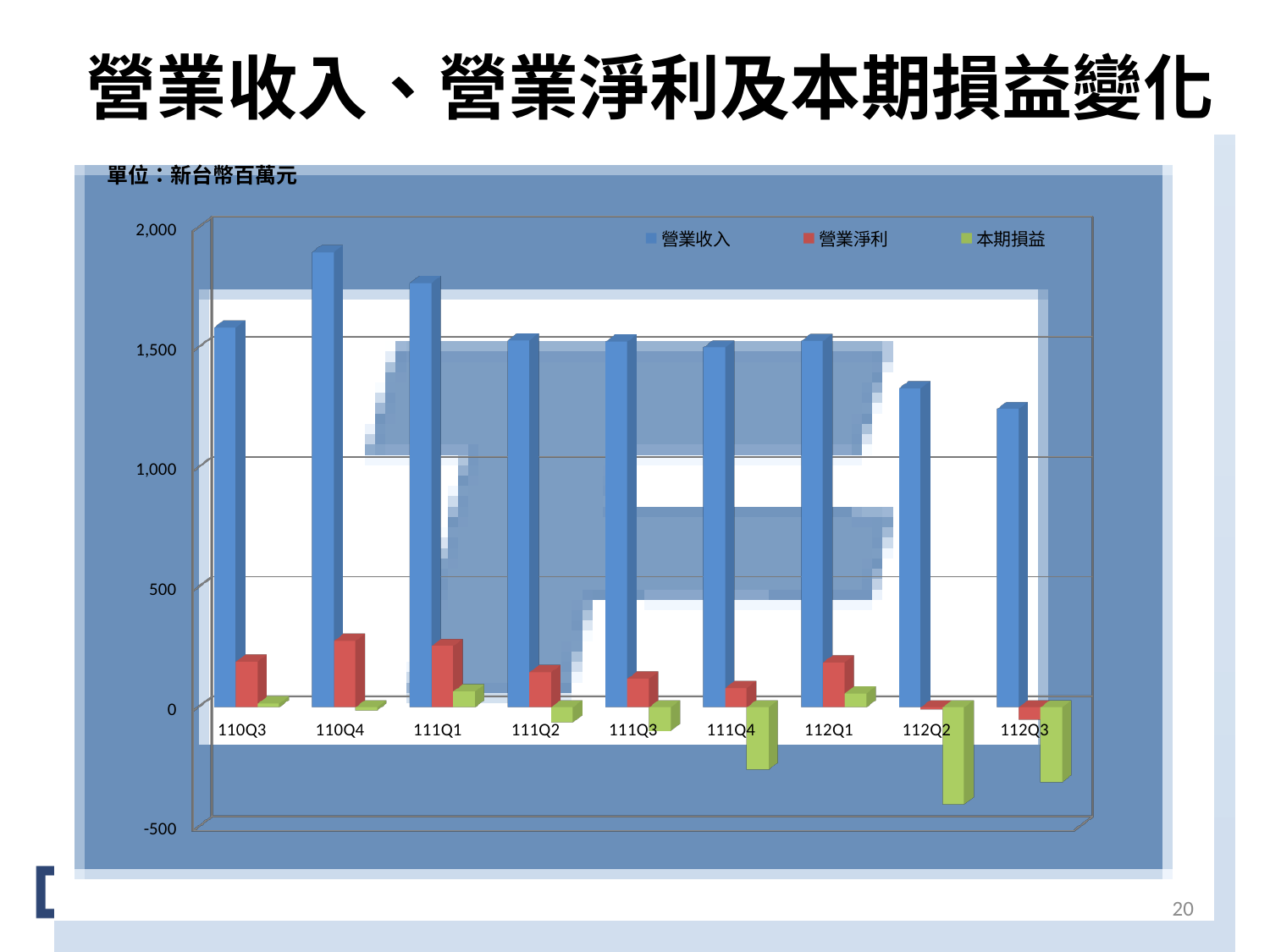
Which quarter has the lowest 本期損益 value? 112Q2 What kind of chart is shown on the slide? bar chart Is the 營業收入 value for 112Q2 greater or less than 1,500? less Which quarter has the highest 營業收入 value? 110Q4 What unit is stated above the chart? 新台幣百萬元 Is the 本期損益 value for 112Q2 greater or less than 0? less Which quarter has the lowest 營業收入 value? 112Q3 How many quarters are shown on the x axis of the chart? 9 Is the 營業收入 value for 110Q4 greater or less than 1,500? greater Which is larger, the 營業收入 value for 111Q1 or for 112Q1? 111Q1 How many series does the chart legend list? 3 Does the 本期損益 value rise or fall from 112Q1 to 112Q2? fall